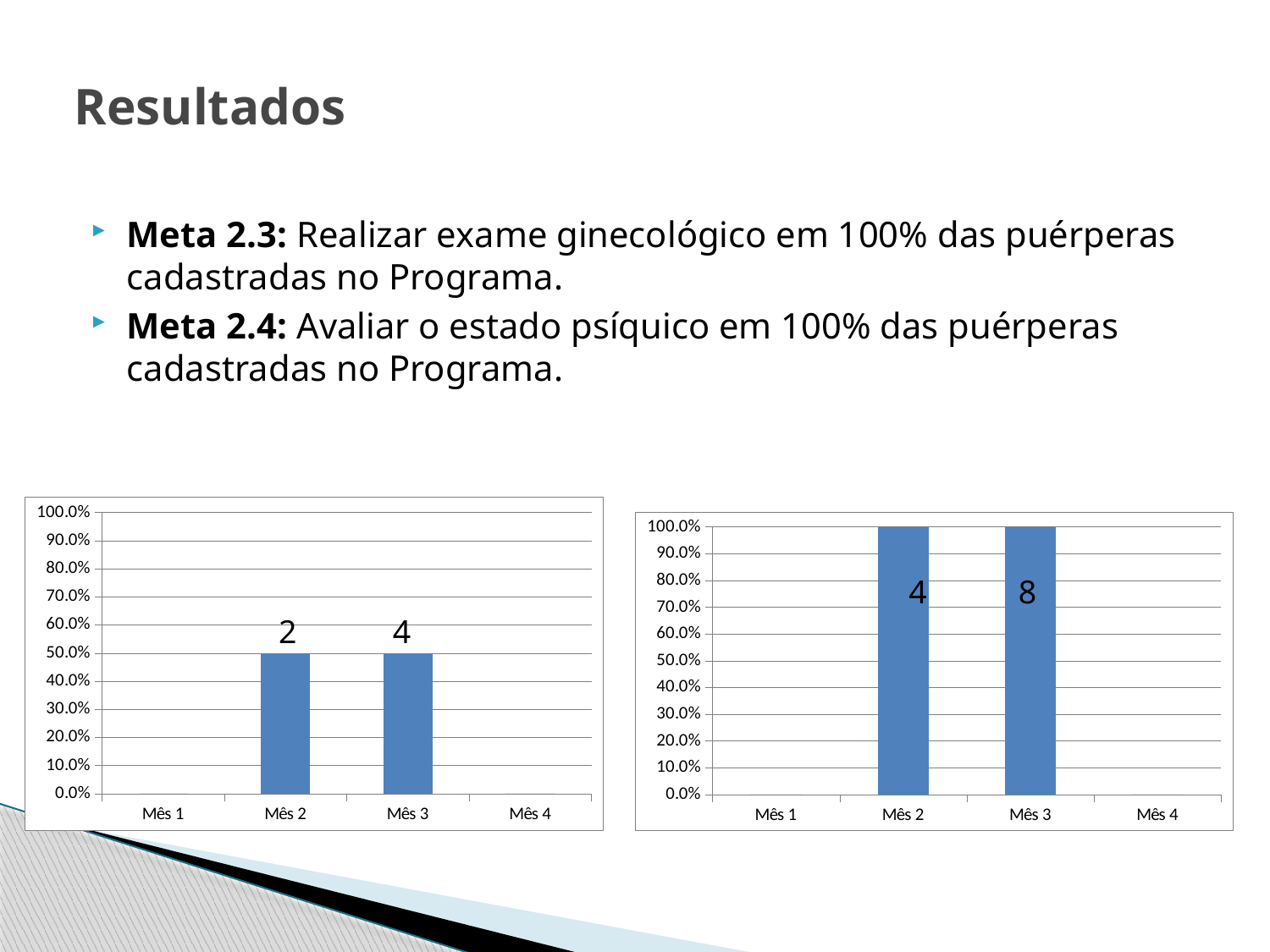
In the left chart, what percentage does the bar for Mês 2 reach on the y axis? 50.0% In the left chart, is the bar for Mês 3 greater or less than 60.0%? less In the right chart, what data label is printed on the bar for Mês 3? 8 In the right chart, is the bar for Mês 2 greater or less than 90.0%? greater In the right chart, what data label is printed on the bar for Mês 2? 4 What kind of chart is the left chart on the slide? bar chart In the left chart, what data label is printed on the bar for Mês 2? 2 Which categories in the left chart have no bar plotted? Mês 1 and Mês 4 In the left chart, what data label is printed on the bar for Mês 3? 4 How many categories are shown on the x axis of the right chart? 4 In the right chart, what is the difference between the data labels for Mês 3 and Mês 2? 4 In the right chart, what percentage does the bar for Mês 3 reach on the y axis? 100.0%